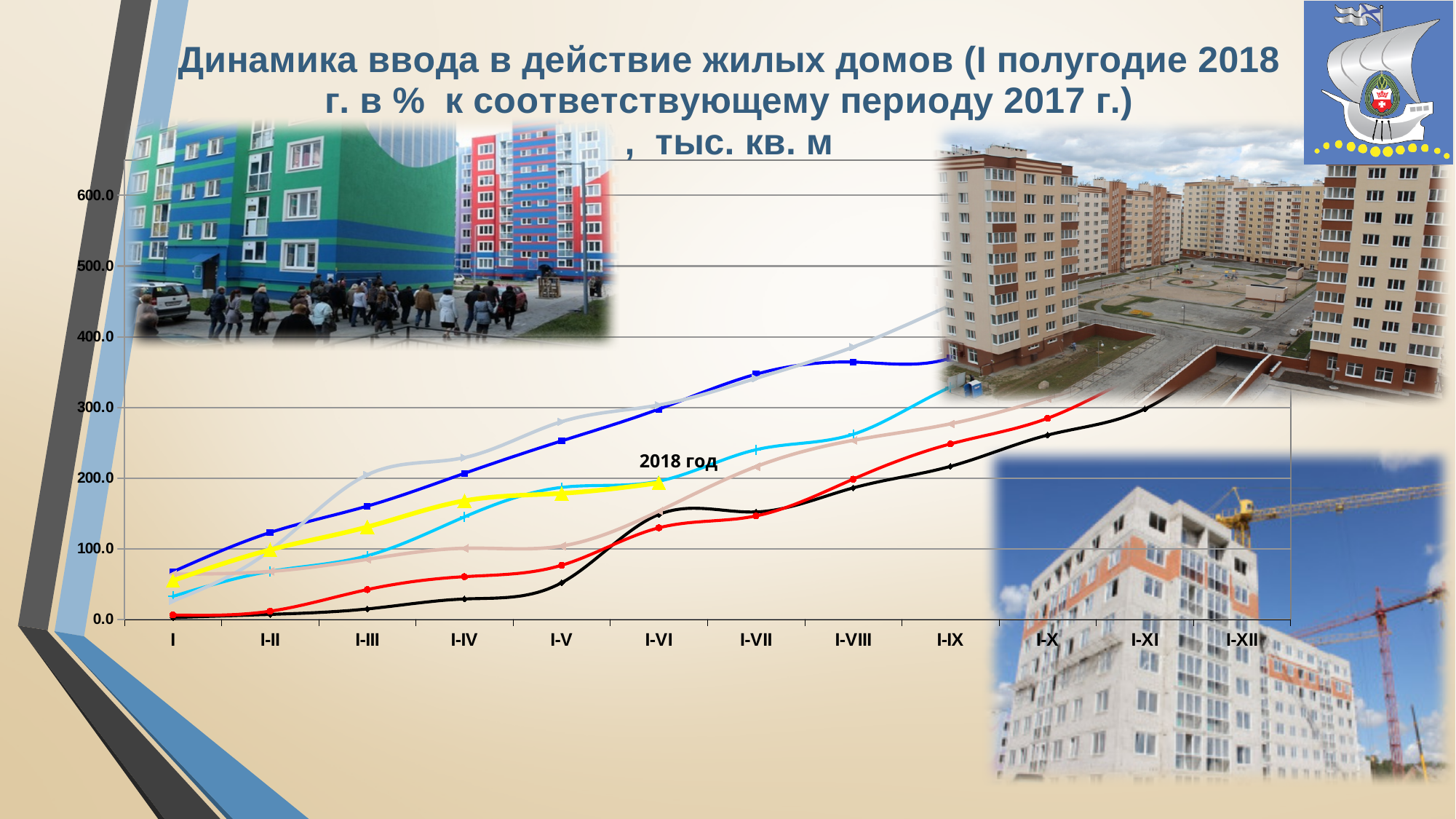
Is the value of the yellow line at I-VI greater or less than 200? less Is the value of the black line at I-X greater or less than 200? greater Which line on the chart is labelled "2018 год"? the yellow line Does the yellow line rise or fall from I to I-VI? rise Is the value of the light blue (cyan) line at I-VIII greater or less than 200? greater How many categories are labelled along the x axis of the chart? 12 What is the last x-axis category label on the chart? I-XII At I-IX, which line has the higher value: the light gray line or the red line? the light gray line At I-VI, which line has the higher value: the blue line or the yellow line? the blue line What kind of chart is shown on the slide? line chart